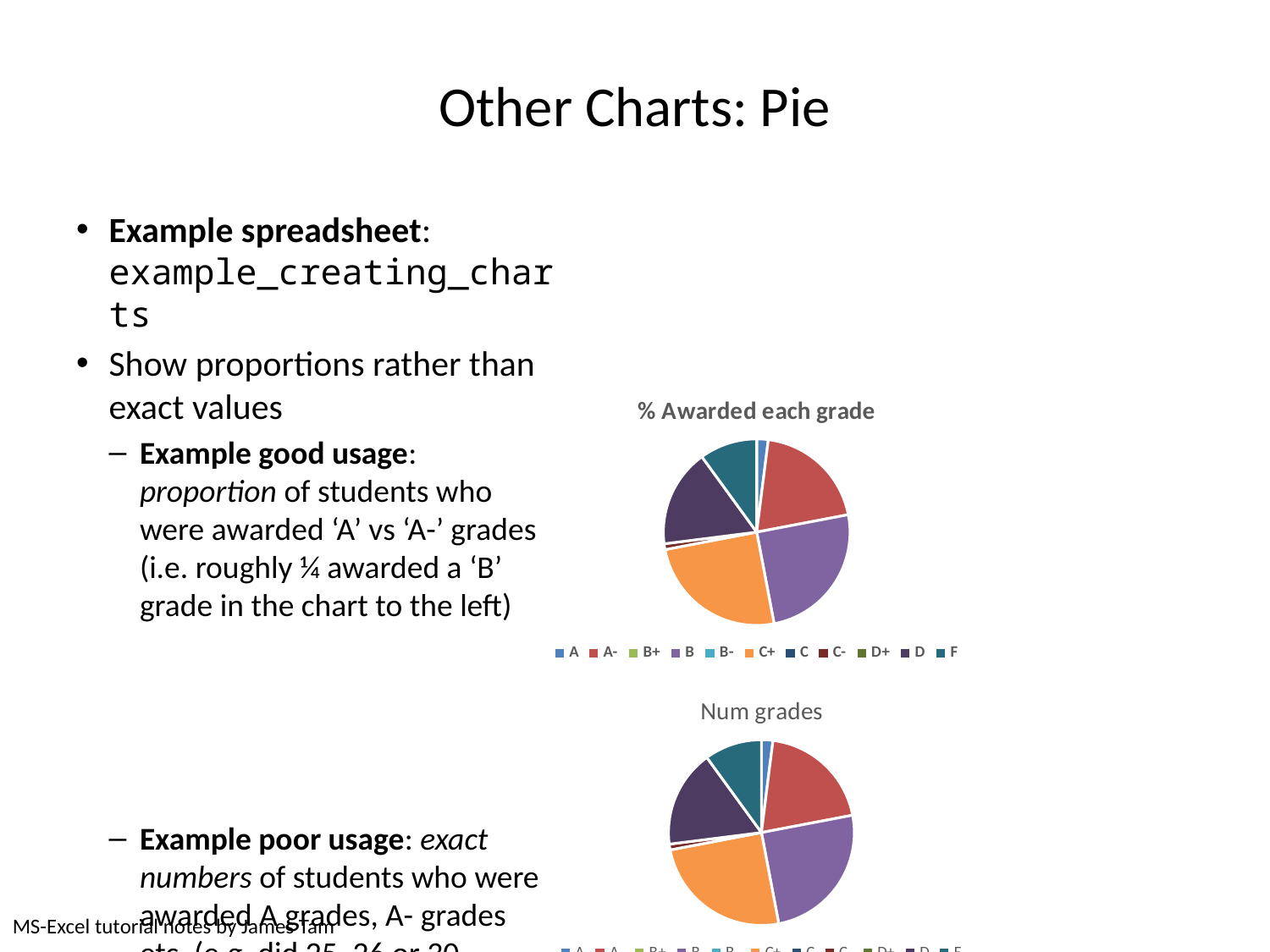
In the top chart "% Awarded each grade", which slice is larger, A- or A? A- In the top chart "% Awarded each grade", which slice is larger, C+ or D? C+ In the top chart "% Awarded each grade", which slice is larger, B or F? B What kind of chart is the bottom chart titled "Num grades"? pie chart What is the title of the top pie chart? % Awarded each grade In the top chart "% Awarded each grade", how many grade categories does the legend list? 11 What is the title of the bottom pie chart? Num grades What kind of chart is the top chart titled "% Awarded each grade"? pie chart How many charts are shown on the slide? 2